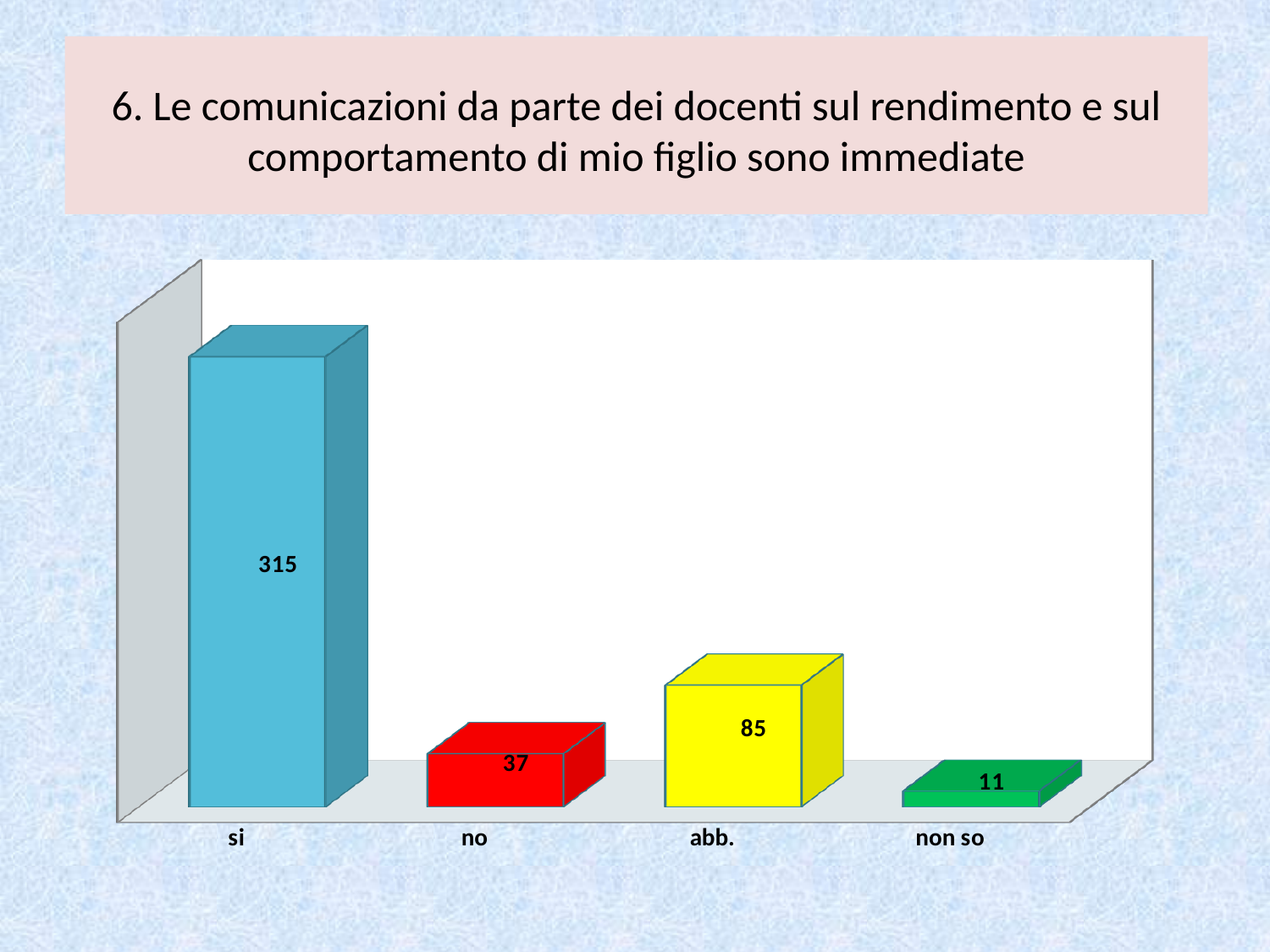
What is the difference between the values for "si" and "abb."? 230 Which category has the highest value? si What colour is the bar for "abb."? yellow Which is larger, the value for "no" or the value for "abb."? abb. What kind of chart is shown on the slide? bar chart What is the value for "abb."? 85 Which category has the lowest value? non so How many categories are shown on the x axis? 4 What is the difference between the values for "abb." and "no"? 48 What is the value for "si"? 315 What is the value for "no"? 37 What is the value for "non so"? 11